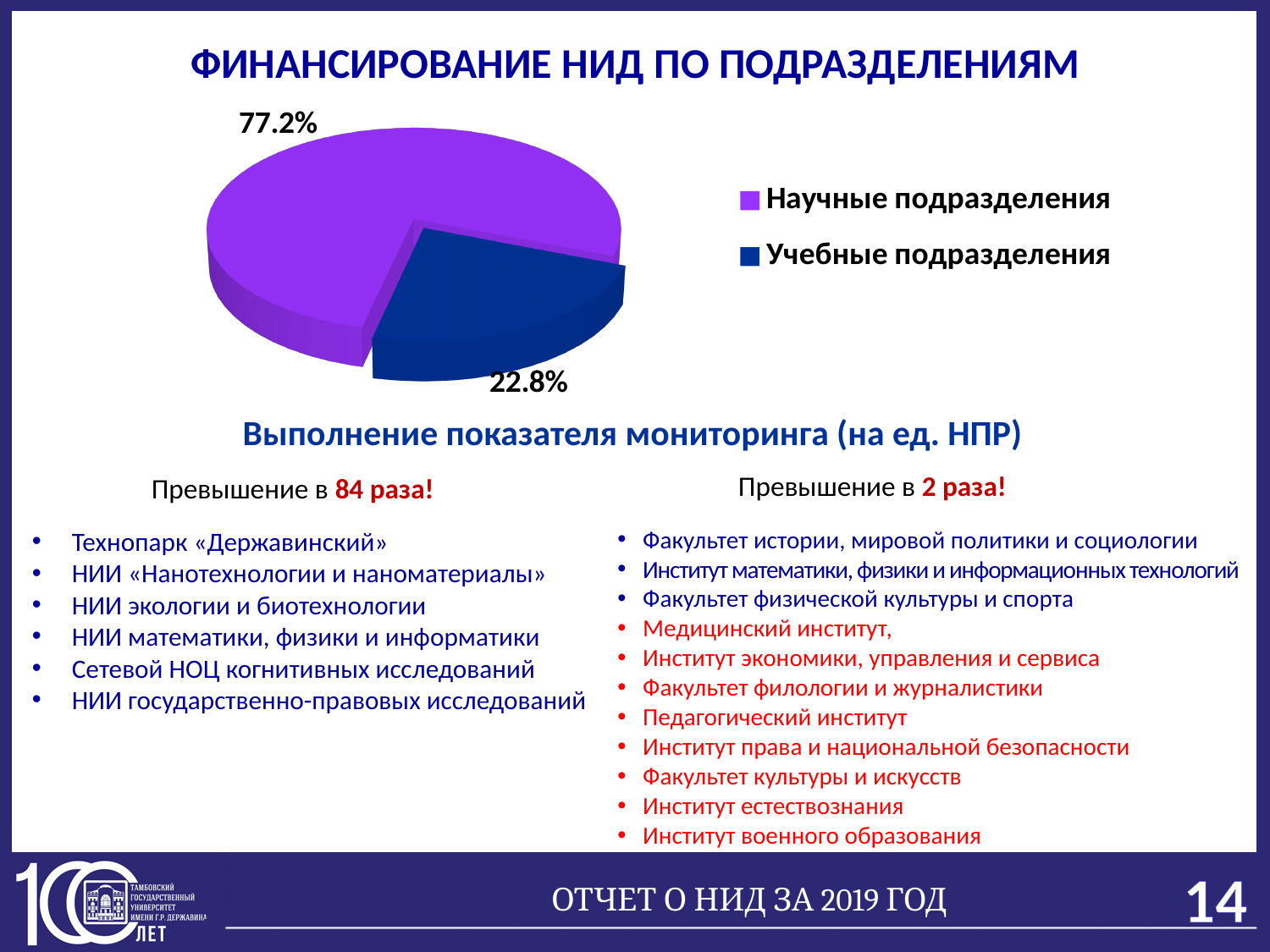
How many entries does the legend list? 2 What is the difference in percentage points between the Научные подразделения slice and the Учебные подразделения slice? 54.4 Which category has the smallest slice of the pie? Учебные подразделения What is the total of the two percentage labels shown on the pie chart? 100% What share of the pie is labelled for Научные подразделения? 77.2% Which slice is larger: Научные подразделения or Учебные подразделения? Научные подразделения How many slices does the pie chart have? 2 What is the title of the chart on the slide? ФИНАНСИРОВАНИЕ НИД ПО ПОДРАЗДЕЛЕНИЯМ What type of chart is shown on the slide? Pie chart What share of the pie is labelled for Учебные подразделения? 22.8% Which category has the largest slice of the pie? Научные подразделения What colour is the slice for Учебные подразделения? Dark blue